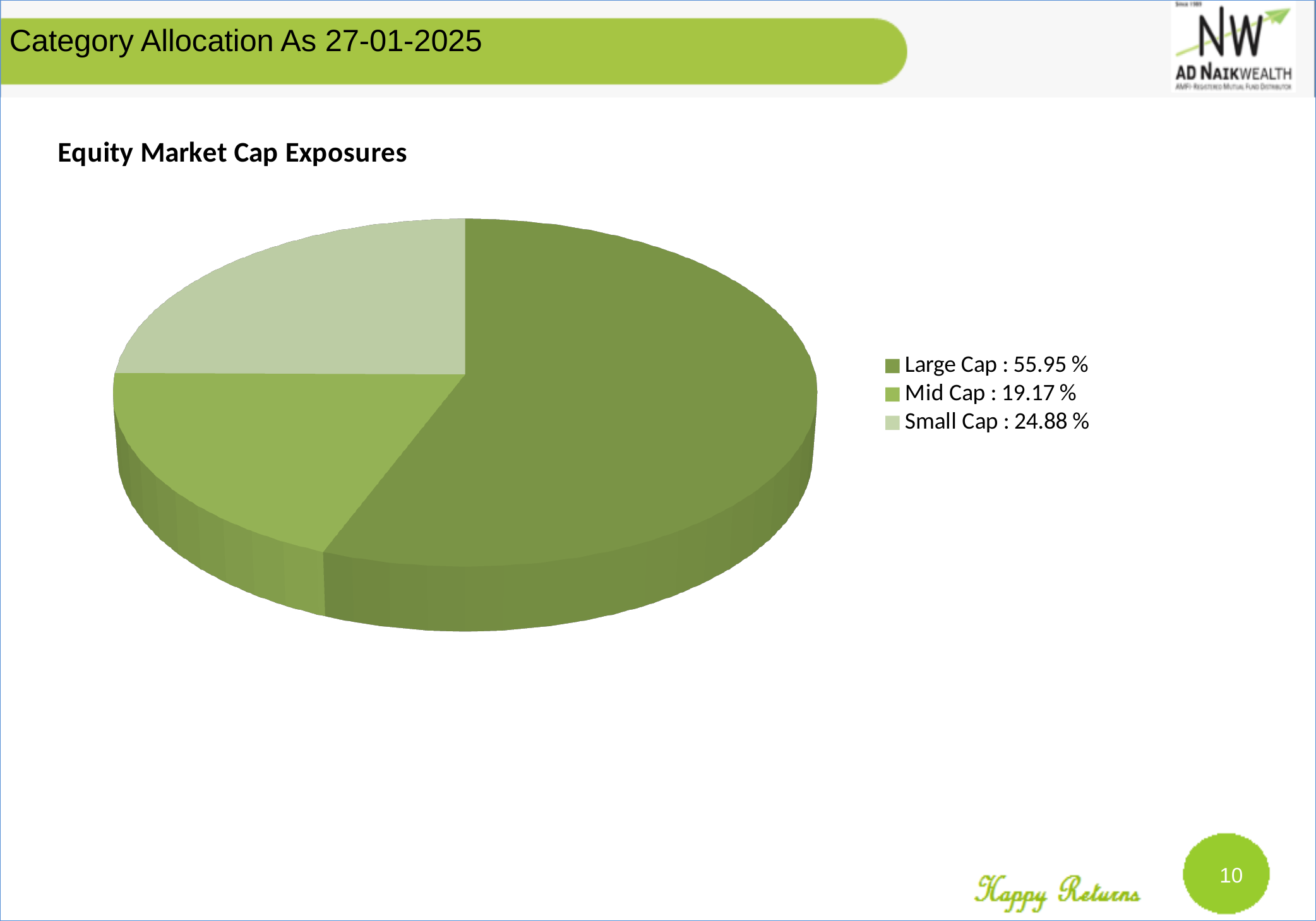
What is the value for Mid Cap in the Equity Market Cap Exposures pie chart? 19.17 % Which category has the largest share in the Equity Market Cap Exposures pie chart? Large Cap Which category has the smallest share in the Equity Market Cap Exposures pie chart? Mid Cap Which is larger in the Equity Market Cap Exposures pie chart, Small Cap or Mid Cap? Small Cap What is the value for Small Cap in the Equity Market Cap Exposures pie chart? 24.88 % How many categories are shown in the Equity Market Cap Exposures pie chart? 3 What kind of chart is used for Equity Market Cap Exposures? Pie chart What is the difference between the Large Cap and Mid Cap values in the Equity Market Cap Exposures pie chart? 36.78 % Which category is shown in the lightest green colour in the Equity Market Cap Exposures pie chart? Small Cap What is the difference between the Small Cap and Mid Cap values in the Equity Market Cap Exposures pie chart? 5.71 % What is the title of the chart on the slide? Equity Market Cap Exposures What is the value for Large Cap in the Equity Market Cap Exposures pie chart? 55.95 %